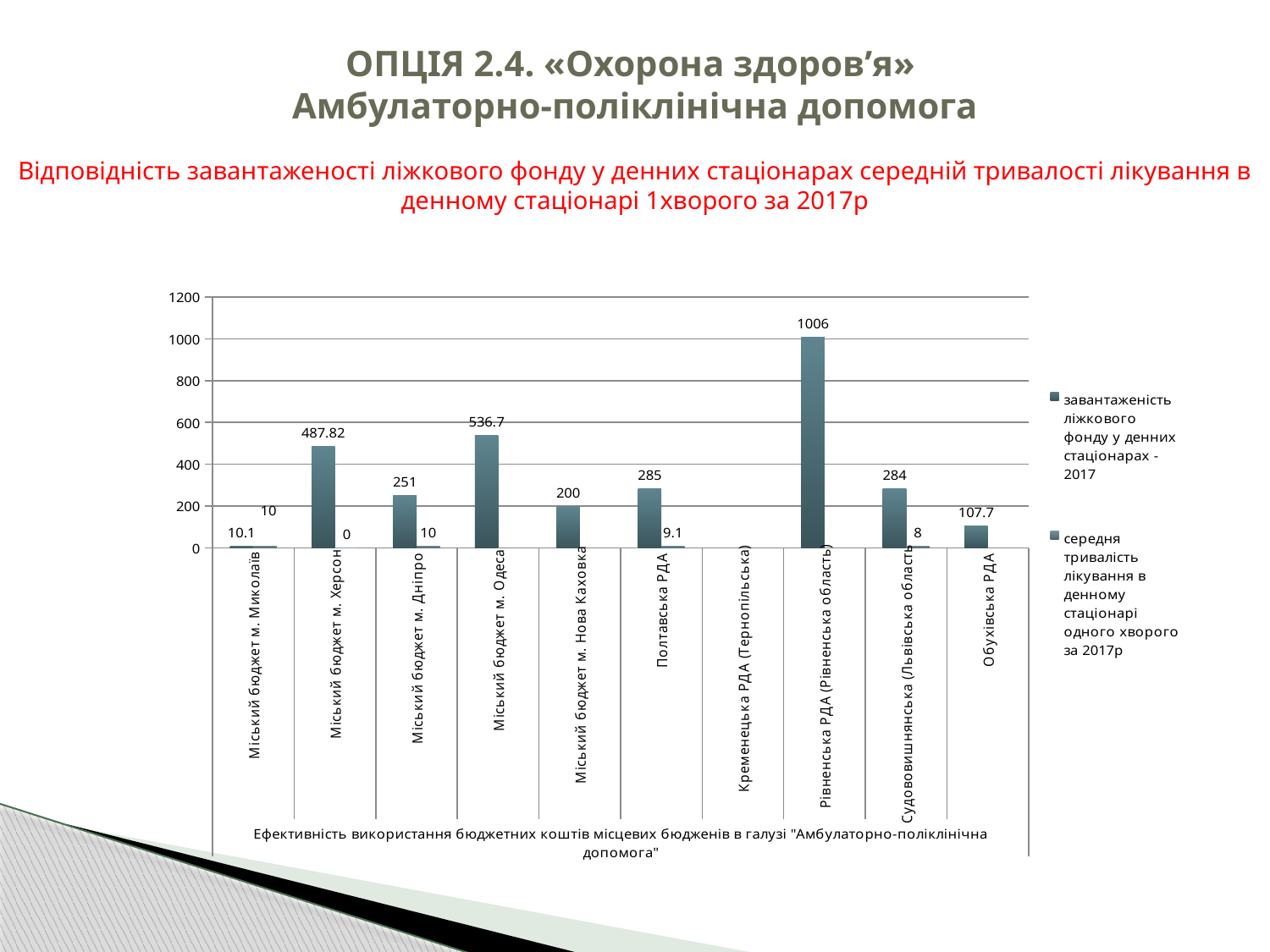
What is the difference between the завантаженість ліжкового фонду values for Міський бюджет м. Херсон and Міський бюджет м. Дніпро? 236.82 How many series does the legend list? 2 Which has a larger завантаженість ліжкового фонду value: Міський бюджет м. Одеса or Міський бюджет м. Херсон? Міський бюджет м. Одеса How many categories are shown on the x axis of the chart? 10 Which category has the highest value of завантаженість ліжкового фонду у денних стаціонарах - 2017? Рівненська РДА (Рівненська область) What is the value of завантаженість ліжкового фонду у денних стаціонарах - 2017 for Рівненська РДА (Рівненська область)? 1006 Is the завантаженість ліжкового фонду value for Рівненська РДА (Рівненська область) greater or less than 800? greater What is the value of середня тривалість лікування в денному стаціонарі одного хворого за 2017р for Полтавська РДА? 9.1 What is the value of завантаженість ліжкового фонду у денних стаціонарах - 2017 for Обухівська РДА? 107.7 What kind of chart is shown on the slide? bar chart What is the value of завантаженість ліжкового фонду у денних стаціонарах - 2017 for Міський бюджет м. Херсон? 487.82 What is the difference between the завантаженість ліжкового фонду values for Рівненська РДА (Рівненська область) and Міський бюджет м. Одеса? 469.3